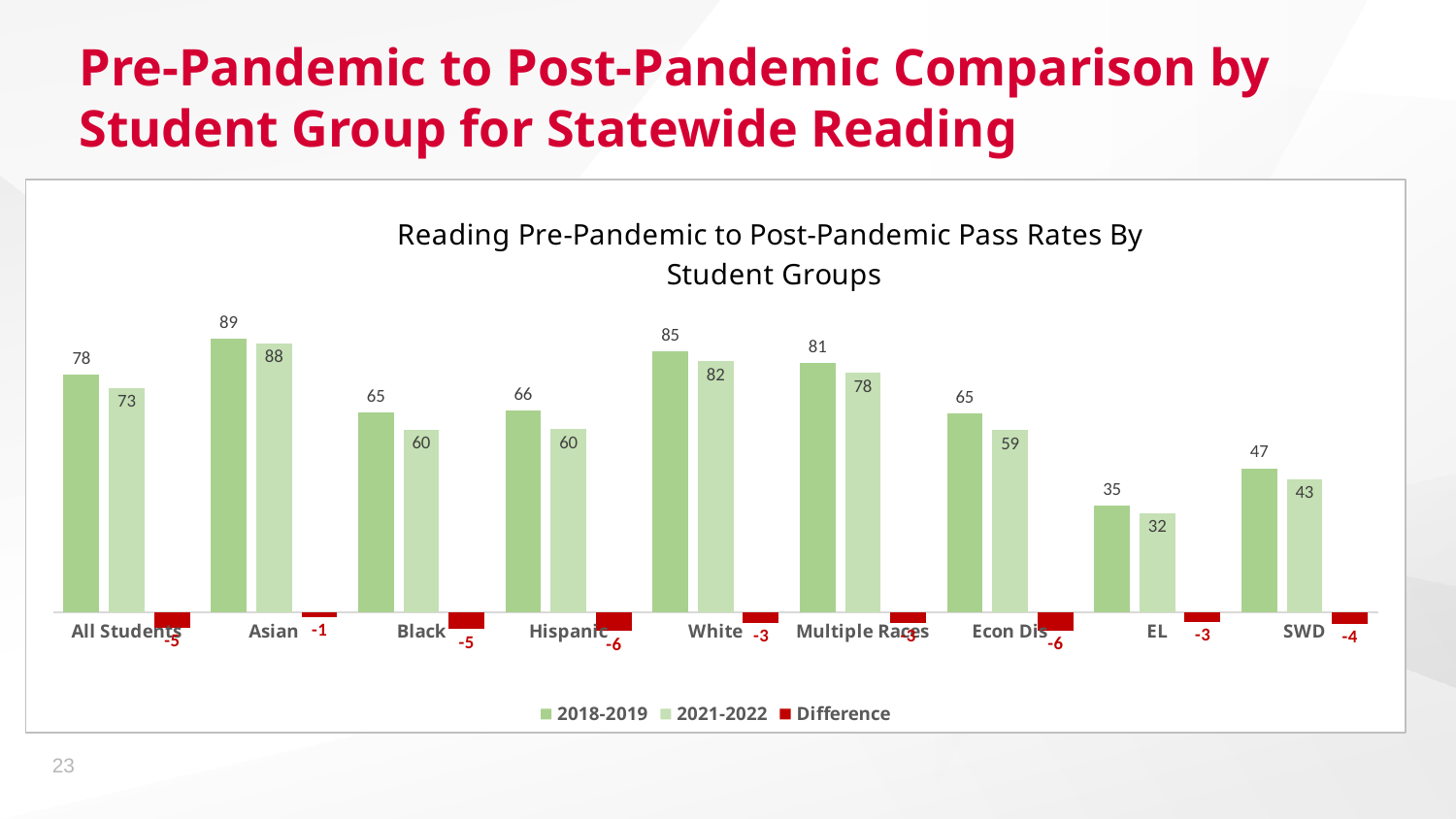
Which student group had the highest 2018-2019 pass rate? Asian What is the difference between the 2018-2019 and 2021-2022 pass rates for SWD? 4 What was the 2021-2022 reading pass rate for Econ Dis students? 59 What is the title of the chart? Reading Pre-Pandemic to Post-Pandemic Pass Rates By Student Groups How many student groups are shown on the x axis? 9 How many series does the legend list? 3 Which student group had the lowest 2021-2022 pass rate? EL Which is larger, the 2021-2022 pass rate for White students or for Multiple Races students? White What colour are the Difference bars in the chart? Red What kind of chart is shown on the slide? Bar chart What is the Difference value shown for Hispanic students? -6 What was the 2018-2019 reading pass rate for All Students? 78